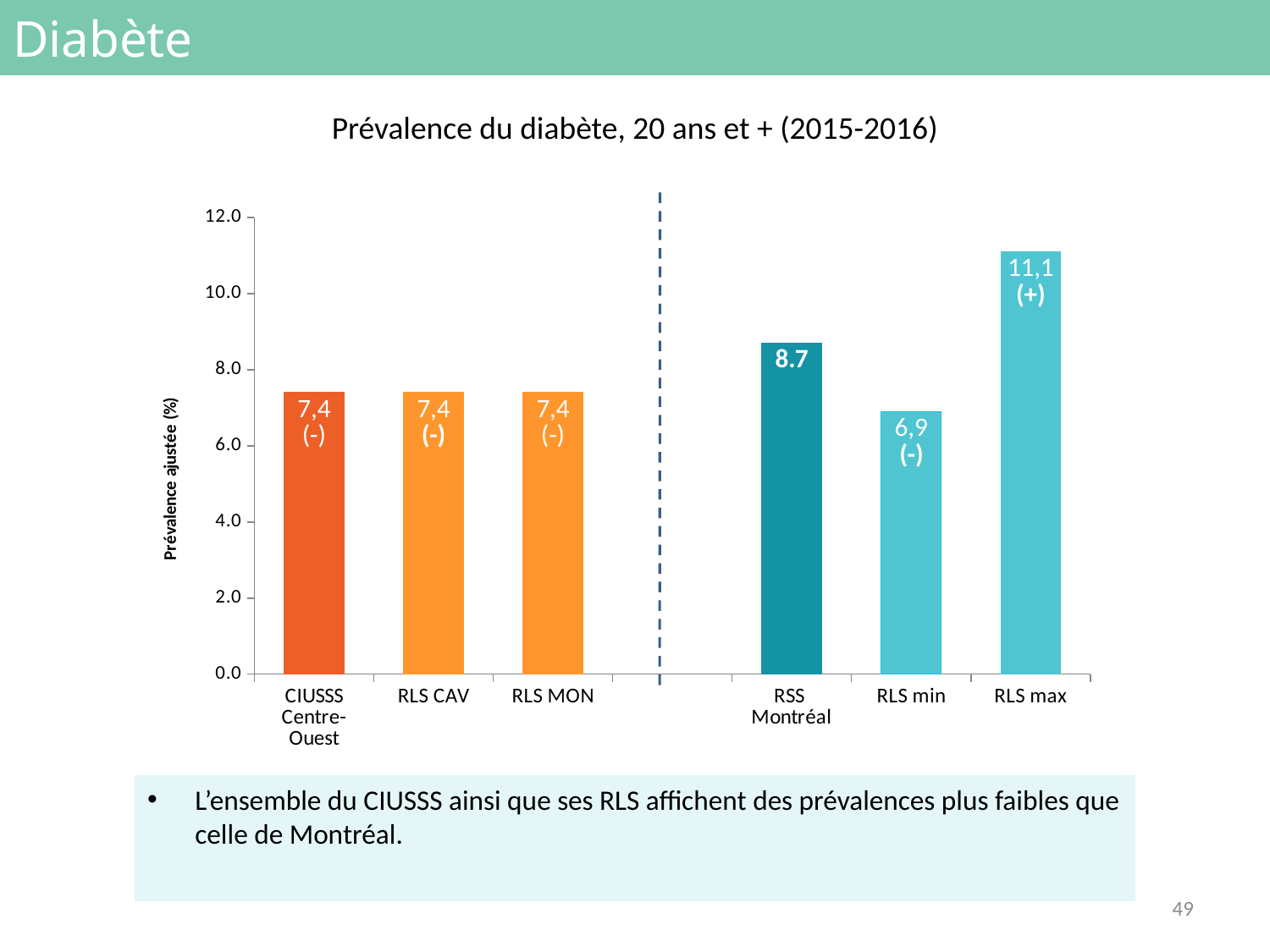
Which is larger, the value for RSS Montréal or the value for RLS MON? RSS Montréal Which category has the lowest value? RLS min What is the title of the chart? Prévalence du diabète, 20 ans et + (2015-2016) What kind of chart is shown? Bar chart What is the difference between the values for RLS max and RLS min? 4,2 What is the value for RSS Montréal? 8.7 What is the difference between the values for RSS Montréal and RLS CAV? 1,3 How many categories are shown on the x axis? 6 Which category has the highest value? RLS max What is the value for RLS max? 11,1 What is the value for RLS min? 6,9 What is the value for CIUSSS Centre-Ouest? 7,4